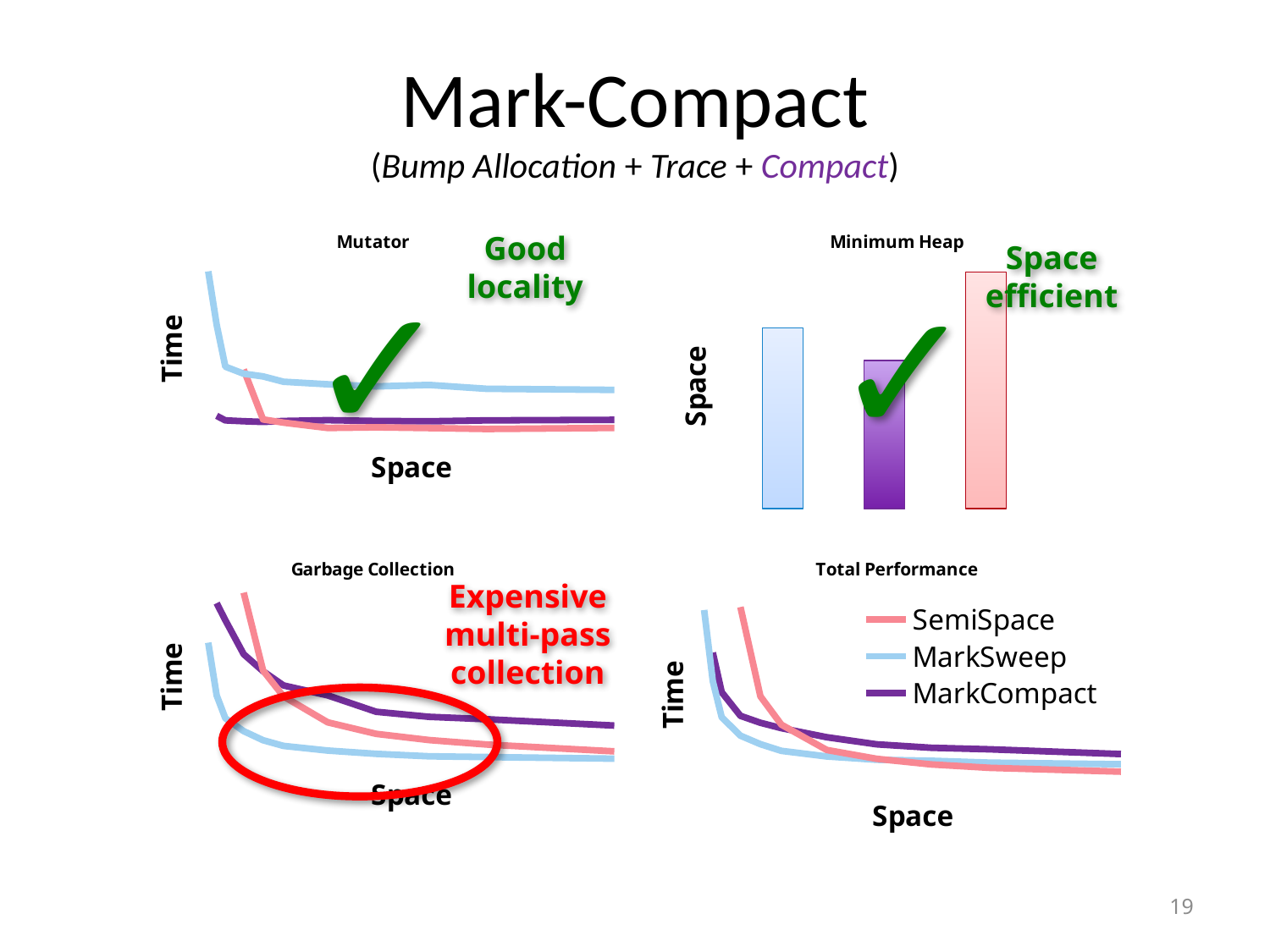
How many bars are shown in the "Minimum Heap" chart? 3 In the "Minimum Heap" chart, which collector has the tallest bar? SemiSpace How many series does the legend on the "Total Performance" chart list? 3 In the "Minimum Heap" chart, which collector has the shortest bar? MarkCompact In the "Minimum Heap" chart, is the MarkSweep bar taller or shorter than the MarkCompact bar? taller In the "Mutator" chart, which series has the highest line at the right-hand end of the x axis? MarkSweep What kind of chart is the "Total Performance" chart? line chart In the "Garbage Collection" chart, does the MarkCompact line rise or fall as Space increases? fall What is the label on the y axis of the "Minimum Heap" chart? Space In the "Total Performance" chart, do the lines rise or fall as Space increases? fall Which series is drawn in purple in the "Total Performance" chart legend? MarkCompact What kind of chart is the "Minimum Heap" chart? bar chart